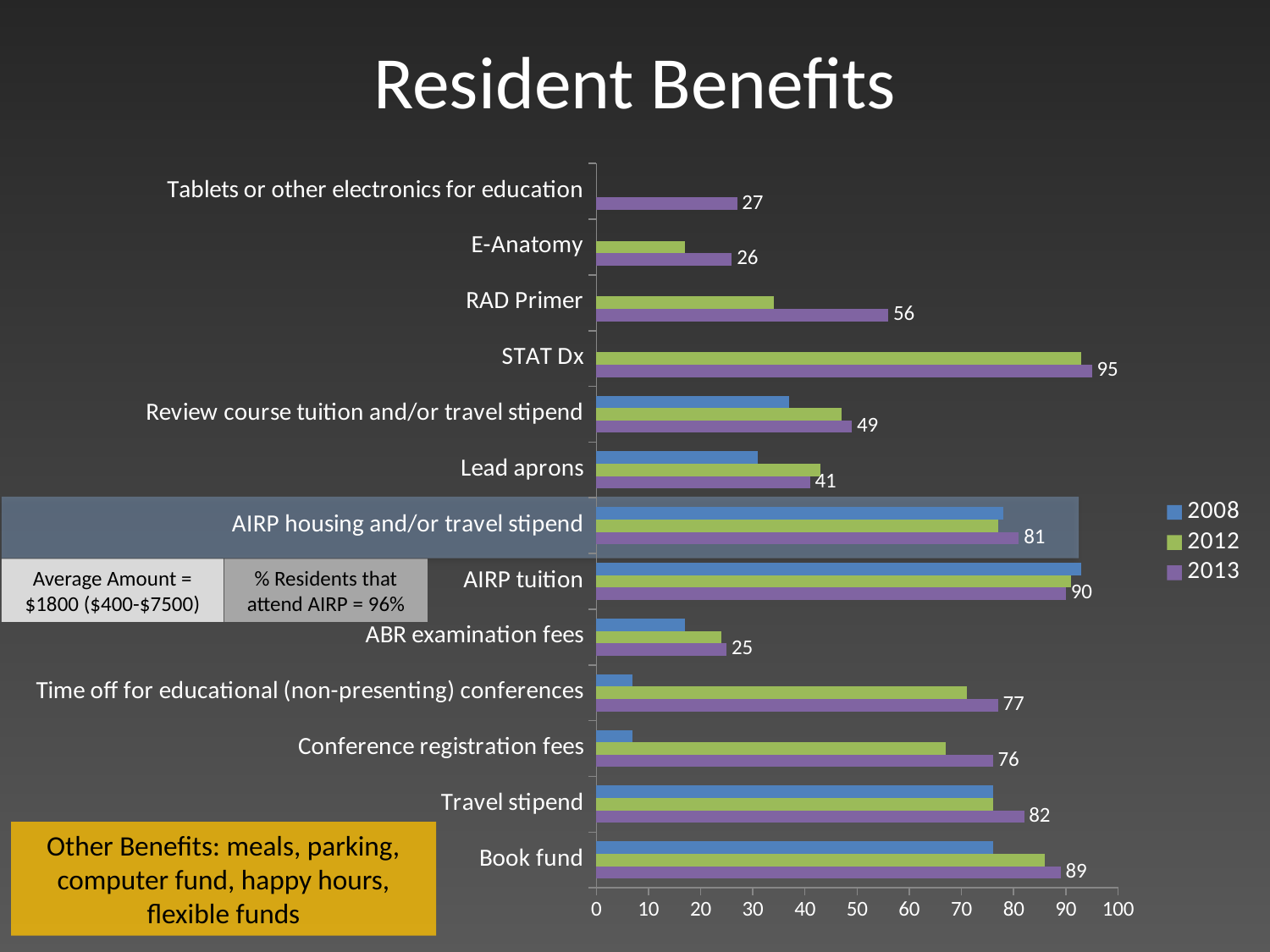
Is the 2008 value for Conference registration fees greater or less than 10? less What is the 2013 value for STAT Dx? 95 How many categories are shown on the chart? 13 Which has the larger 2013 value, Book fund or Travel stipend? Book fund How many series does the legend list? 3 What is the 2013 value for Time off for educational (non-presenting) conferences? 77 What kind of chart is shown on the slide? bar chart Which category has the highest 2013 value? STAT Dx What is the 2013 value for Book fund? 89 What is the 2013 value for Lead aprons? 41 What is the difference between the 2013 values for STAT Dx and ABR examination fees? 70 Which category has the lowest 2013 value? ABR examination fees